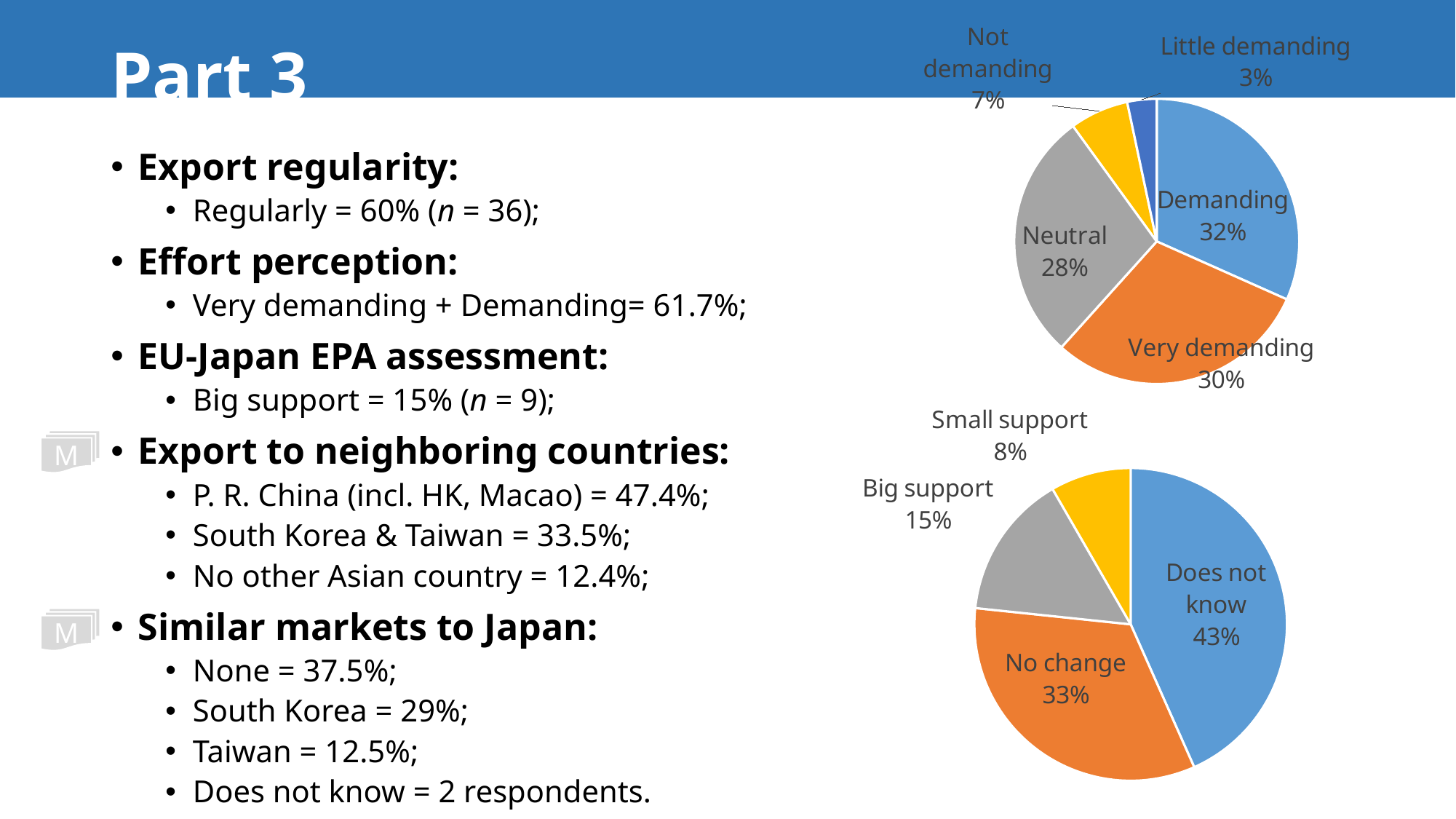
In the top pie chart, what share does the Not demanding slice have? 7% In the top pie chart, what is the difference between the Demanding and Neutral shares? 4% What type of chart is the bottom chart on the slide? Pie chart In the bottom pie chart, which category has the largest slice? Does not know In the bottom pie chart, which category has the smallest slice? Small support In the top pie chart, which category has the largest slice? Demanding In the bottom pie chart, what share does the Big support slice have? 15% In the bottom pie chart, what share does the No change slice have? 33% In the bottom pie chart, which is larger, Big support or Small support? Big support In the top pie chart, which category has the smallest slice? Little demanding In the top pie chart, what share does the Neutral slice have? 28% How many slices does the top pie chart have? 5